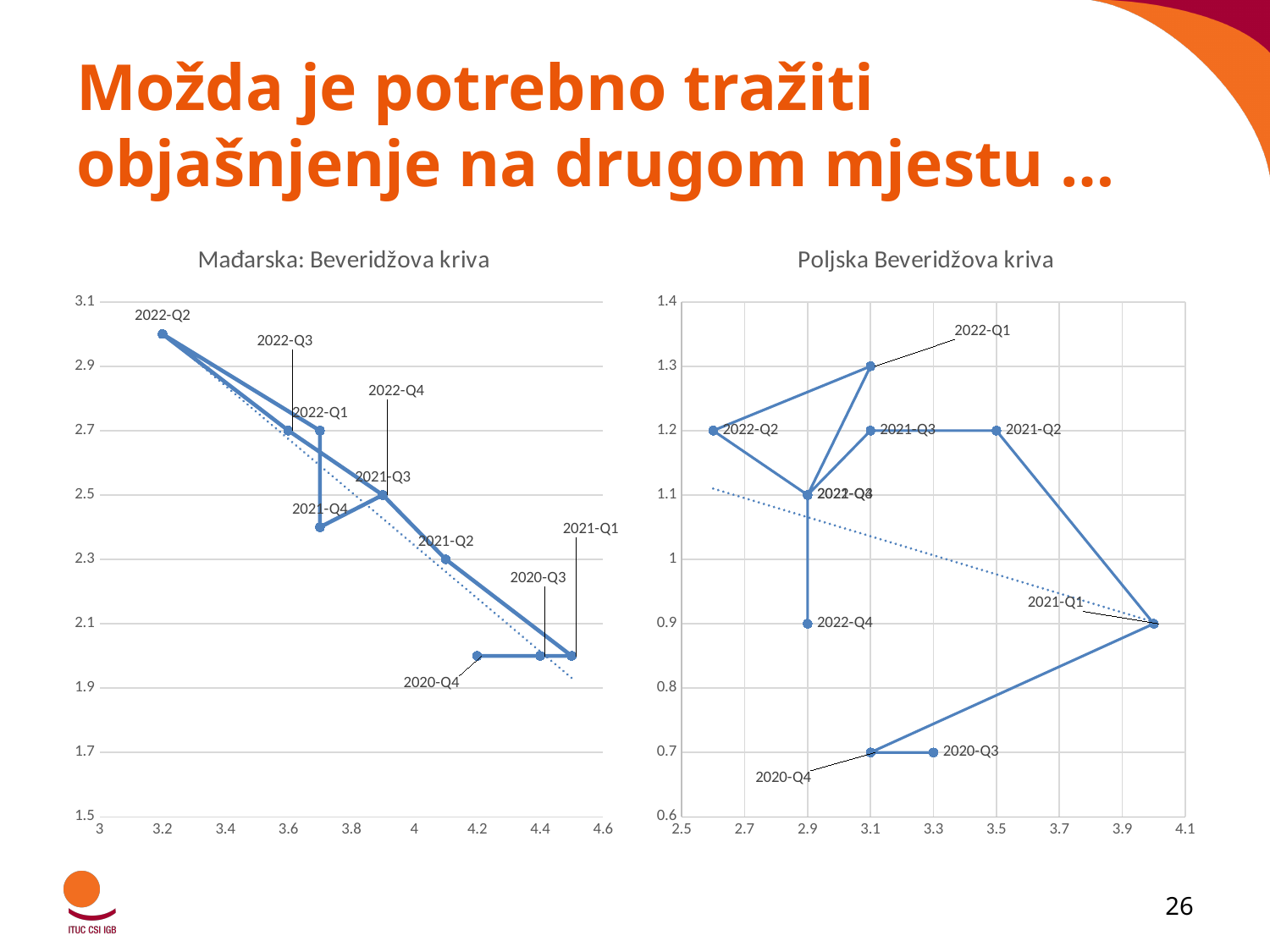
In the 'Poljska Beveridžova kriva' chart, which labelled point has the highest y-axis value? 2022-Q1 In the 'Mađarska: Beveridžova kriva' chart, which point has a higher y-axis value, 2022-Q3 or 2021-Q2? 2022-Q3 In the 'Poljska Beveridžova kriva' chart, what is the highest value shown on the y axis? 1.4 In the 'Poljska Beveridžova kriva' chart, which point has a higher y-axis value, 2021-Q2 or 2020-Q4? 2021-Q2 In the 'Mađarska: Beveridžova kriva' chart, which labelled point has the highest y-axis value? 2022-Q2 In the 'Poljska Beveridžova kriva' chart, is the y-axis value of the 2022-Q4 point greater or less than 1? less In the 'Mađarska: Beveridžova kriva' chart, is the y-axis value of the 2022-Q2 point greater or less than 2.9? greater In the 'Poljska Beveridžova kriva' chart, what is the y-axis value of the 2020-Q3 point? 0.7 In the 'Mađarska: Beveridžova kriva' chart, is the y-axis value of the 2021-Q1 point greater or less than 2.1? less What kind of chart is the 'Mađarska: Beveridžova kriva' chart on the left? scatter chart with connected points In the 'Poljska Beveridžova kriva' chart, what is the y-axis value of the 2022-Q1 point? 1.3 What is the title of the chart on the right side of the slide? Poljska Beveridžova kriva